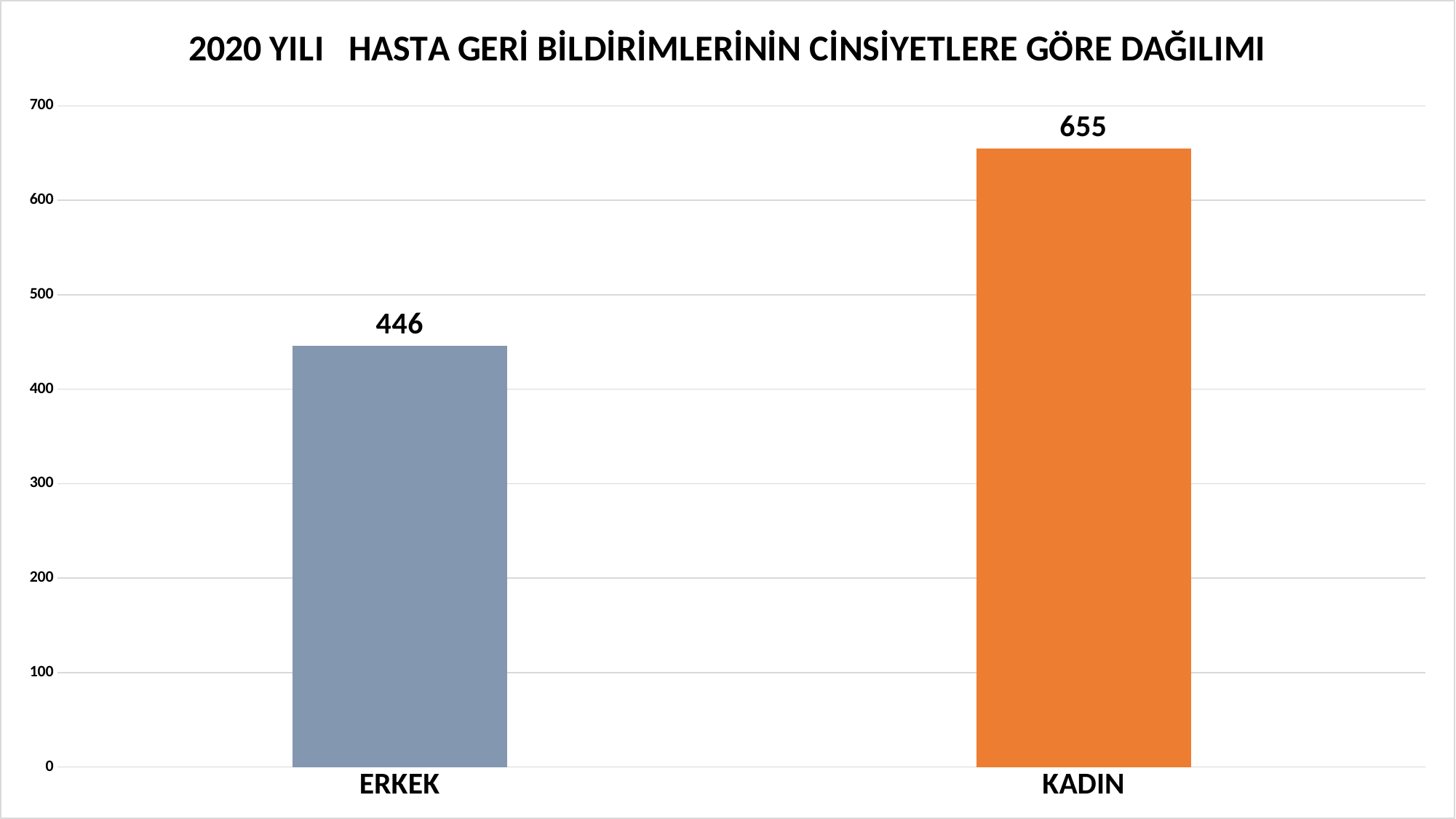
Which category has the lowest value? ERKEK Which is larger, the value for ERKEK or the value for KADIN? KADIN What is the value for KADIN? 655 Which category has the highest value? KADIN What colour is the bar for KADIN? orange What is the value for ERKEK? 446 What is the title of the chart? 2020 YILI HASTA GERİ BİLDİRİMLERİNİN CİNSİYETLERE GÖRE DAĞILIMI Is the value for ERKEK greater or less than 500? less What kind of chart is shown on the slide? bar chart What is the difference between the values for KADIN and ERKEK? 209 How many categories are shown on the chart? 2 Is the value for KADIN greater or less than 600? greater